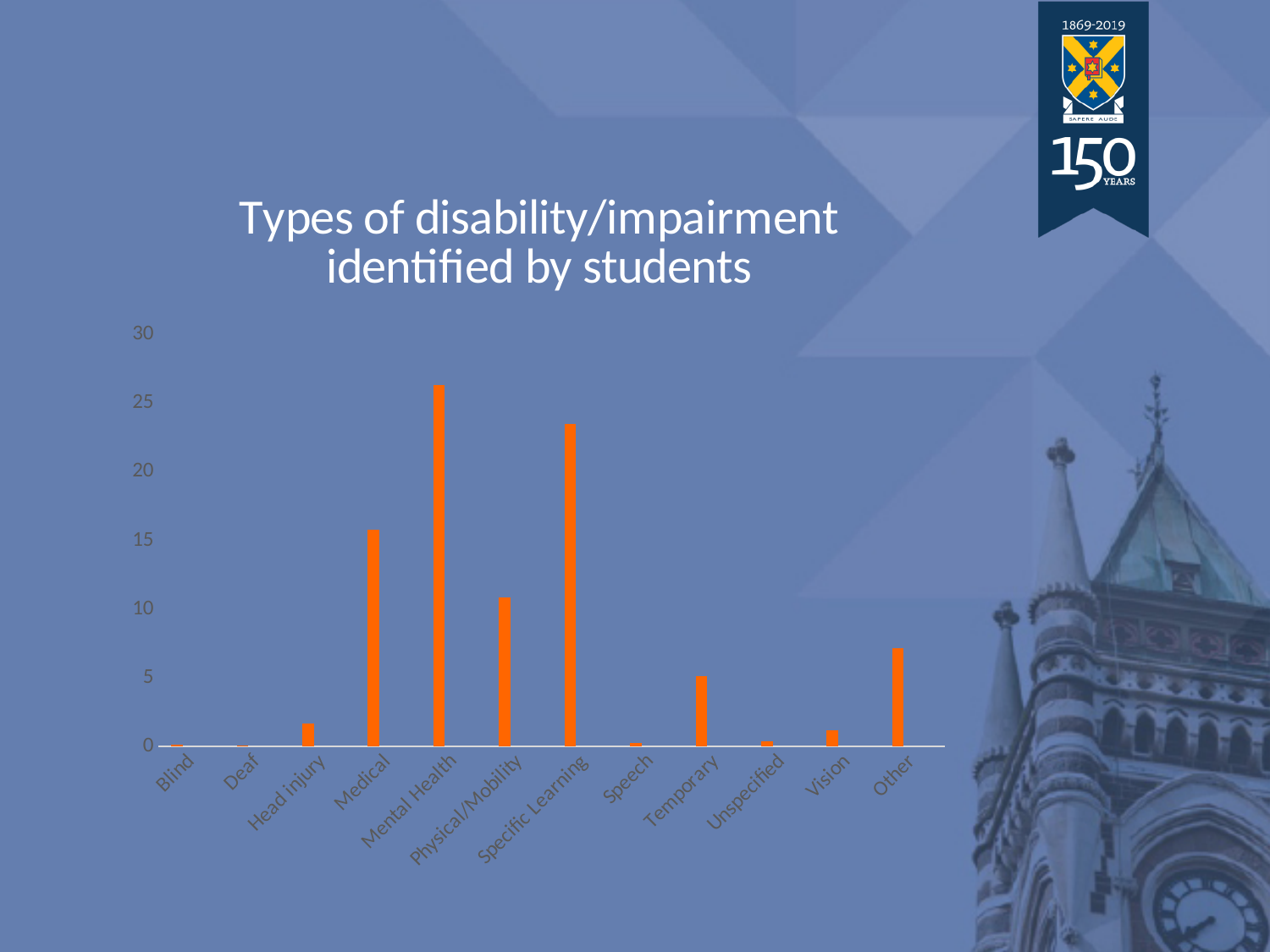
Is the value for Medical greater or less than 20? less Which is larger, the value for Mental Health or the value for Specific Learning? Mental Health Is the value for Head injury greater or less than 5? less Is the value for Physical/Mobility greater or less than 15? less How many categories are shown on the x axis of the chart? 12 Which is larger, the value for Medical or the value for Physical/Mobility? Medical What kind of chart is shown on the slide? bar chart What is the title of the chart? Types of disability/impairment identified by students Which category has the highest bar? Mental Health